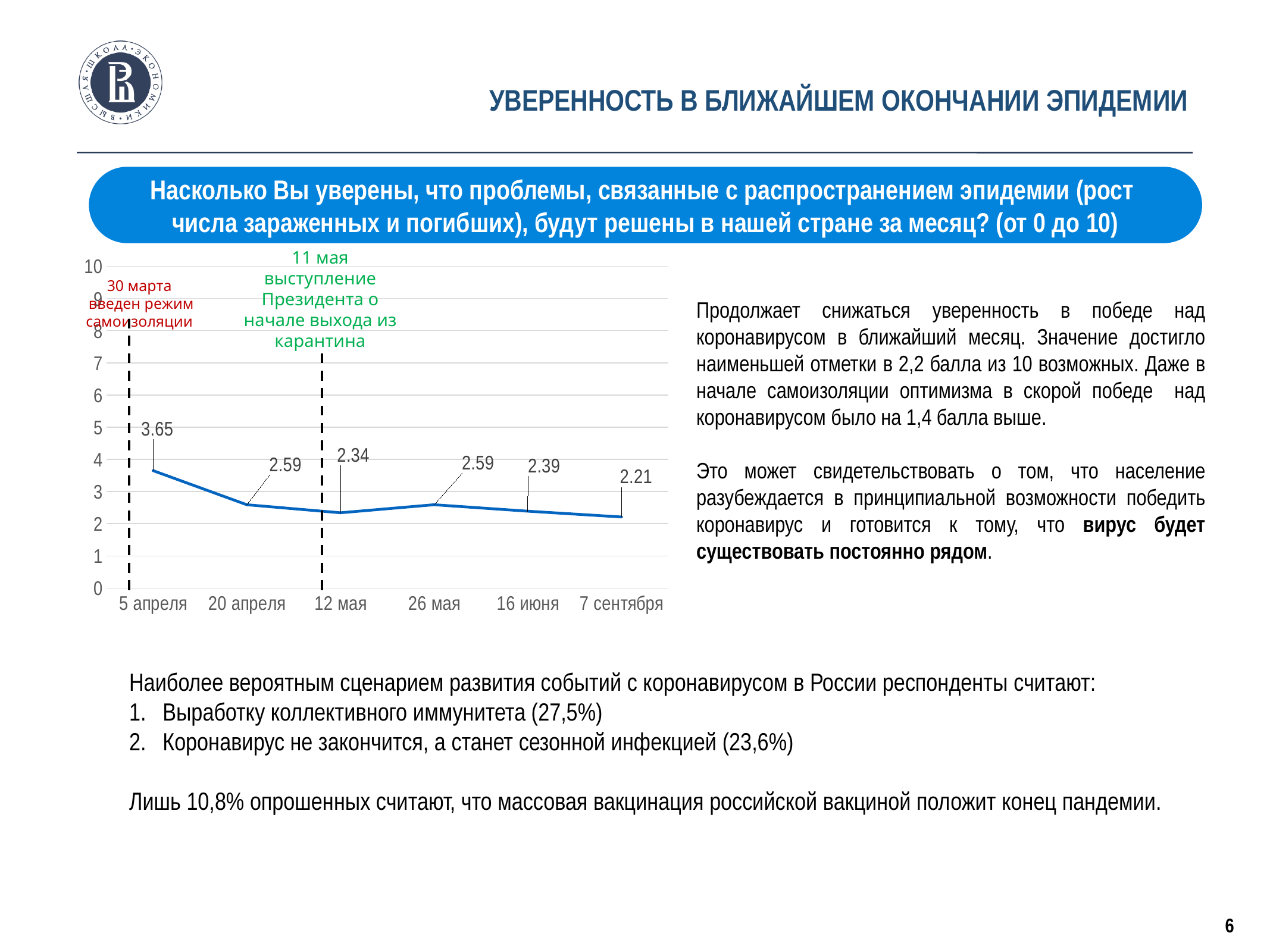
Do the values generally rise or fall from 5 апреля to 7 сентября? fall Which date has the lowest value? 7 сентября Is the value for 5 апреля greater or less than 3? greater Which date has the highest value? 5 апреля What is the value for 5 апреля? 3.65 What is the value for 12 мая? 2.34 What is the difference between the values for 5 апреля and 7 сентября? 1.44 How many dates are plotted on the chart? 6 What is the value for 7 сентября? 2.21 What is the value for 16 июня? 2.39 What kind of chart is shown on the slide? line chart Which is larger, the value for 26 мая or the value for 16 июня? 26 мая